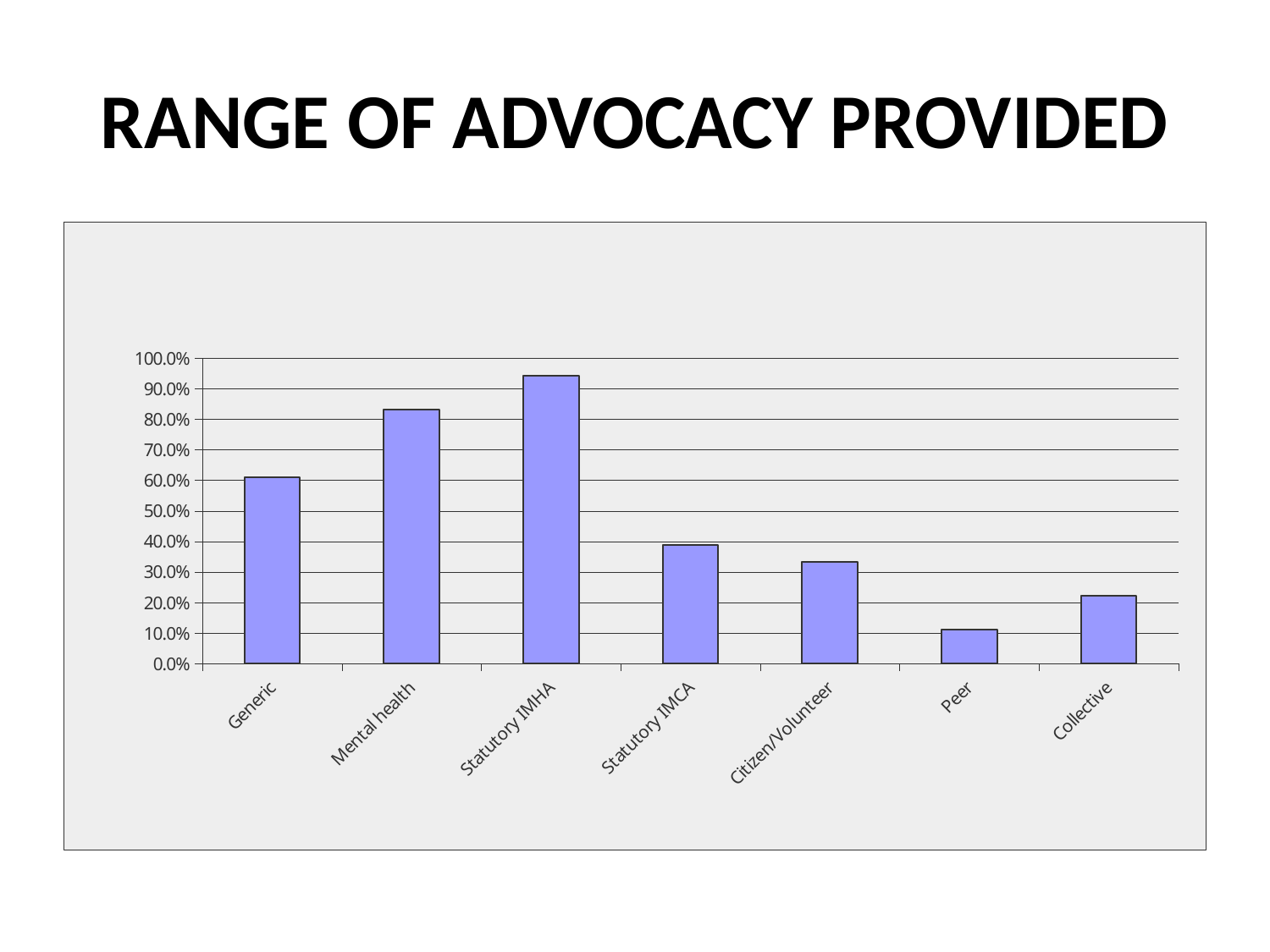
Is the value for Mental health greater or less than 70.0%? greater How many categories are shown on the x axis of the chart? 7 Which category has the lowest value in the chart? Peer Is the value for Peer greater or less than 20.0%? less Which is larger, the value for Mental health or the value for Generic? Mental health Is the value for Generic greater or less than 50.0%? greater What type of chart is shown on the slide? bar chart Which category has the highest value in the chart? Statutory IMHA Which is larger, the value for Citizen/Volunteer or the value for Collective? Citizen/Volunteer What is the title of the slide containing the chart? RANGE OF ADVOCACY PROVIDED